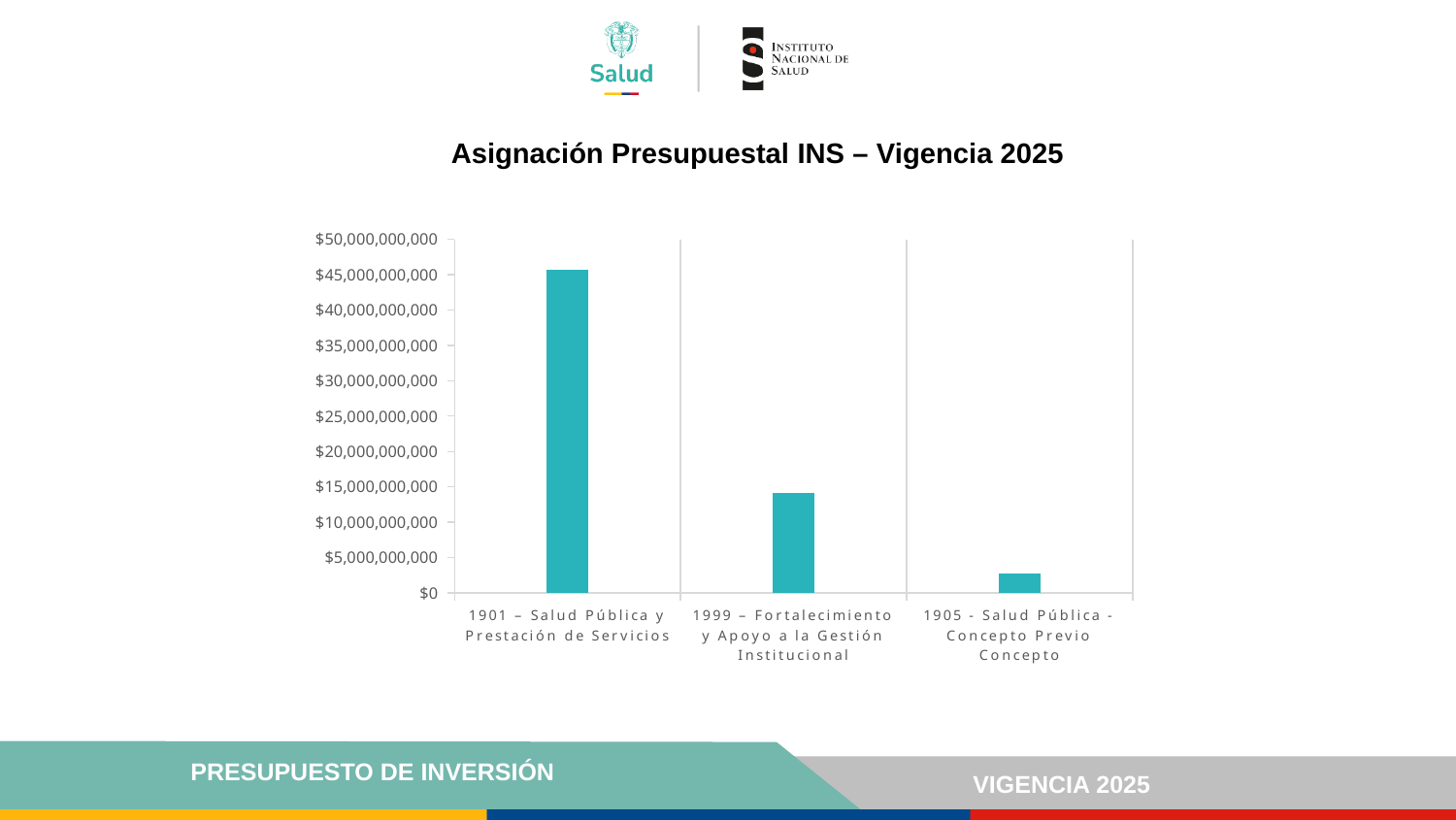
What kind of chart is shown on the slide? bar chart Is the value for 1901 – Salud Pública y Prestación de Servicios greater or less than $40,000,000,000? greater Is the value for 1905 - Salud Pública - Concepto Previo Concepto greater or less than $5,000,000,000? less Which category has the highest value? 1901 – Salud Pública y Prestación de Servicios Which category has the lowest value? 1905 - Salud Pública - Concepto Previo Concepto Is the value for 1901 – Salud Pública y Prestación de Servicios greater or less than $50,000,000,000? less Do the values rise or fall from left to right along the x axis? fall How many categories are plotted on the x axis? 3 Which is larger, the value for 1999 – Fortalecimiento y Apoyo a la Gestión Institucional or the value for 1905 - Salud Pública - Concepto Previo Concepto? 1999 – Fortalecimiento y Apoyo a la Gestión Institucional What is the title of the chart? Asignación Presupuestal INS – Vigencia 2025